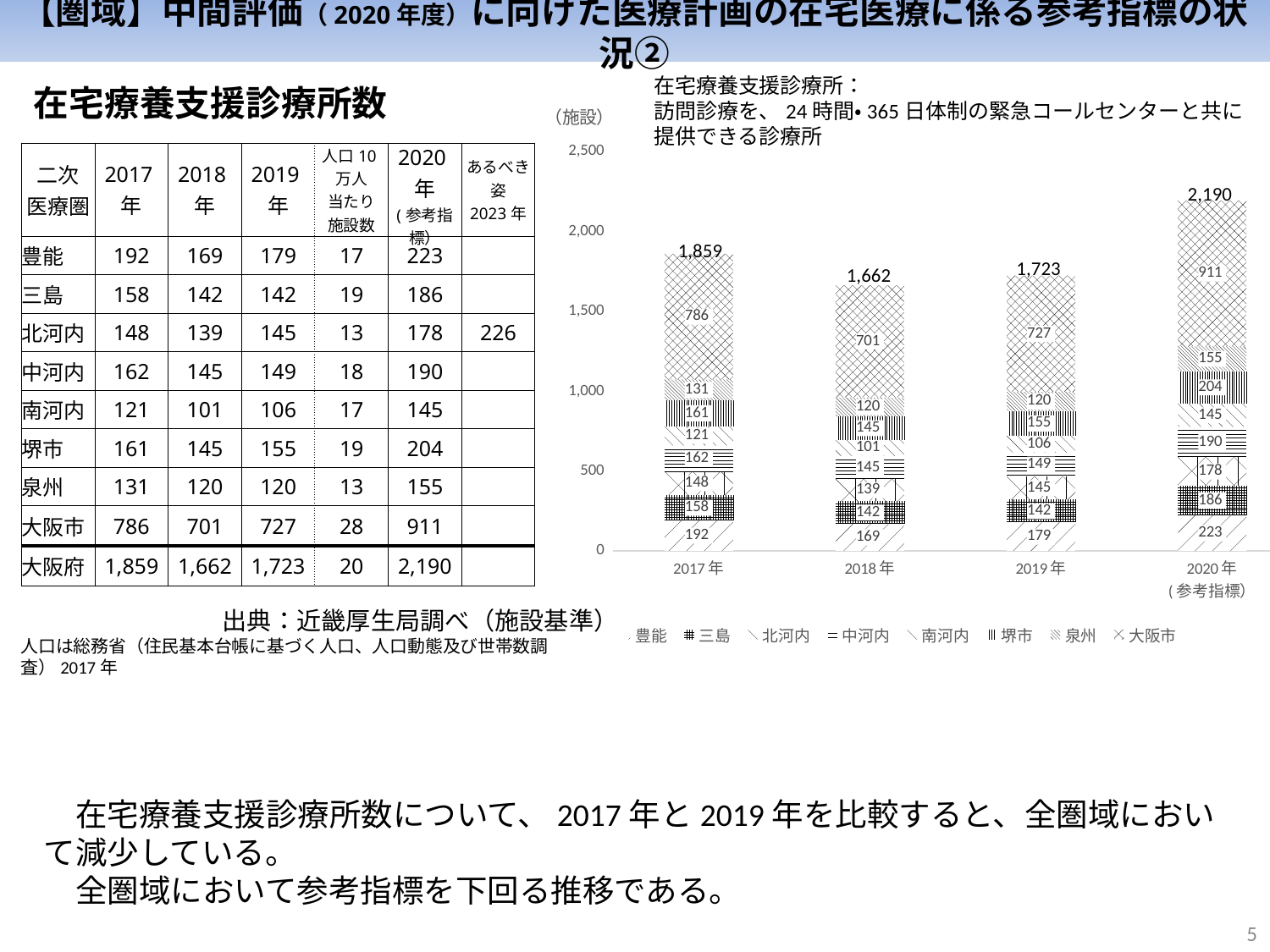
What is the difference between the stacked bar totals for 2019年 and 2018年? 61 Which year has the lowest stacked bar total in the chart? 2018年 What kind of chart is shown on the slide? stacked bar chart Which year has the highest stacked bar total in the chart? 2020年(参考指標) What is the value of the 大阪市 segment in the 2019年 bar? 727 What is the value of the 豊能 segment in the 2018年 bar? 169 Is the stacked bar total for 2018年 larger or smaller than the total for 2019年? smaller How many bars (categories) are plotted on the x axis of the chart? 4 What is the total value of the stacked bar for 2017年? 1,859 How many series does the chart legend list? 8 What is the total value of the stacked bar for 2020年(参考指標)? 2,190 Is the stacked bar total for 2020年(参考指標) greater or less than 2,000? greater